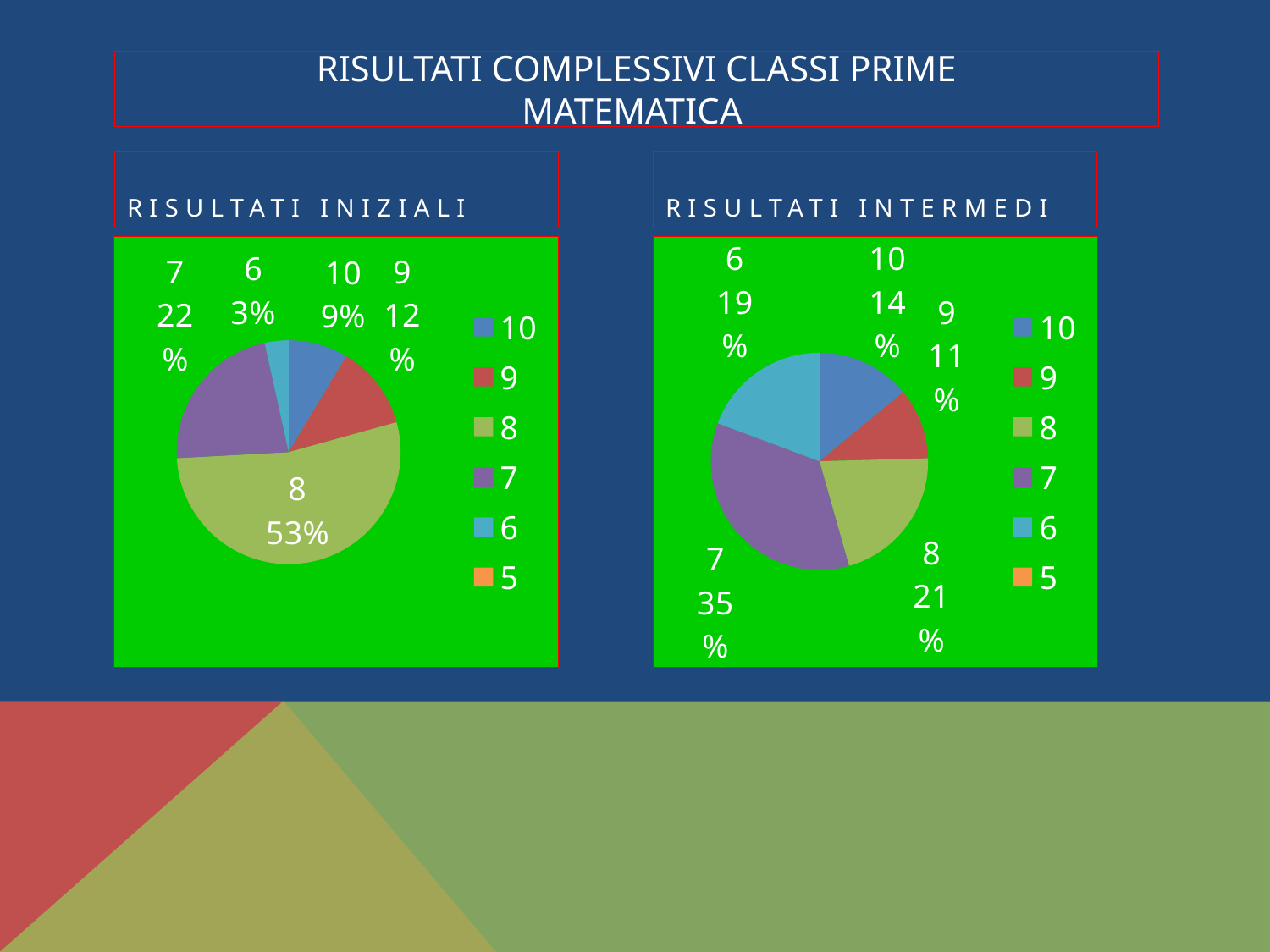
In the RISULTATI INIZIALI chart, which grade has the largest slice? 8 In the RISULTATI INIZIALI chart, what share does grade 8 have? 53% In the RISULTATI INTERMEDI chart, what share does grade 6 have? 19% In the RISULTATI INIZIALI chart, what is the difference between the shares of grade 9 and grade 10? 3% In the RISULTATI INIZIALI chart, what share does grade 6 have? 3% In the RISULTATI INTERMEDI chart, which is larger, the share of grade 8 or the share of grade 9? 8 In the RISULTATI INTERMEDI chart, what share does grade 10 have? 14% In the RISULTATI INTERMEDI chart, which grade has the largest slice? 7 How many entries does the legend of the RISULTATI INTERMEDI chart list? 6 In the RISULTATI INIZIALI chart, what share does grade 7 have? 22% What kind of chart is the RISULTATI INIZIALI chart? Pie chart In the RISULTATI INTERMEDI chart, what share does grade 7 have? 35%